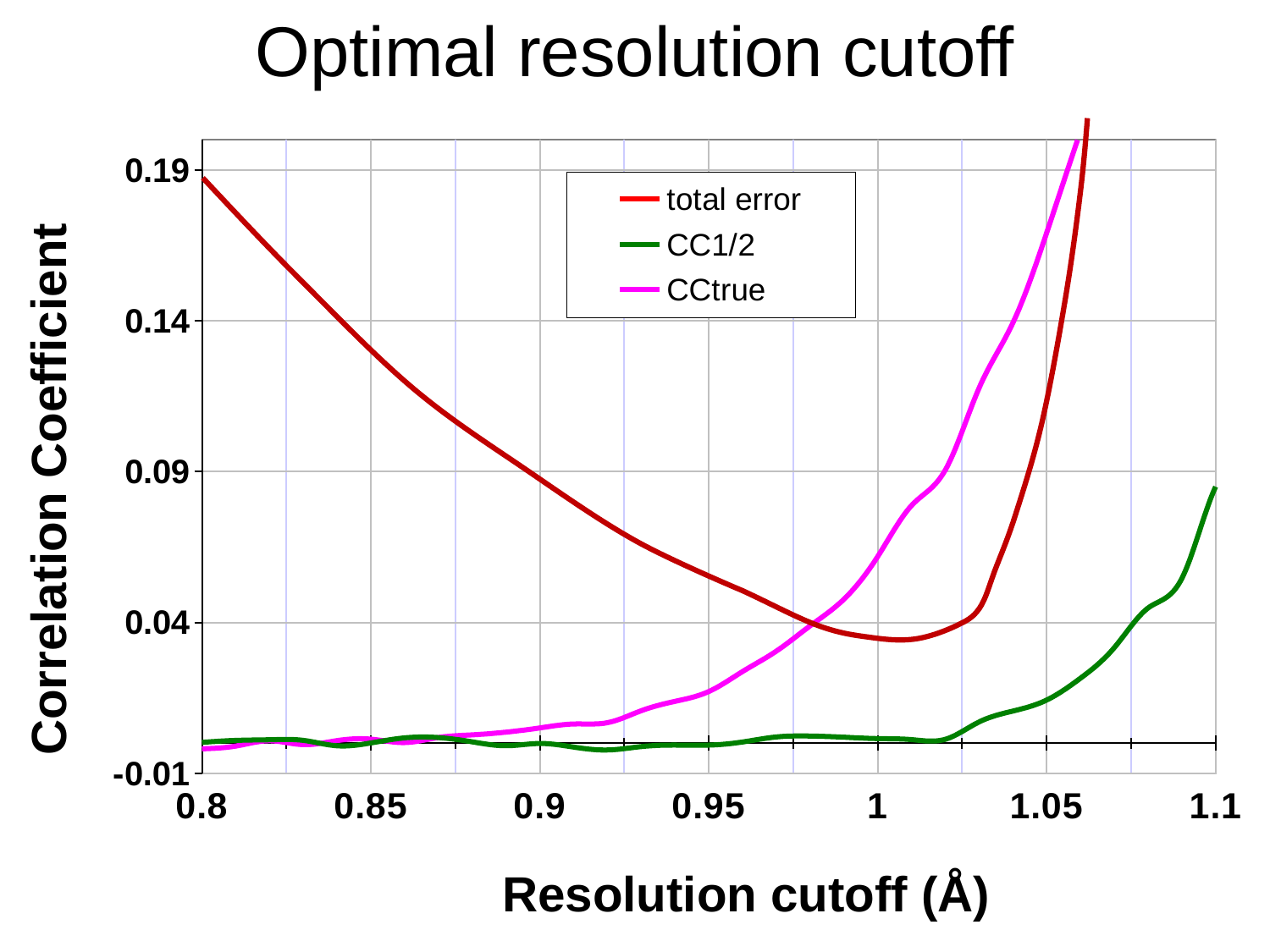
At a resolution cutoff of 1.05, which series has the larger value, CCtrue or total error? CCtrue What kind of chart is shown on the slide? line chart Does the CCtrue series generally rise or fall as the resolution cutoff increases from 0.8 to 1.05? rise What is the label of the x axis? Resolution cutoff (Å) Is the value of CC1/2 at a resolution cutoff of 1.0 greater or less than 0.04? less Which series has the lowest value at a resolution cutoff of 1.05? CC1/2 Is the value of total error at a resolution cutoff of 0.85 greater or less than 0.14? less Is the value of total error at a resolution cutoff of 0.95 greater or less than 0.04? greater How many series does the legend list? 3 At a resolution cutoff of 0.9, which series has the larger value, total error or CCtrue? total error What is the title of the chart? Optimal resolution cutoff